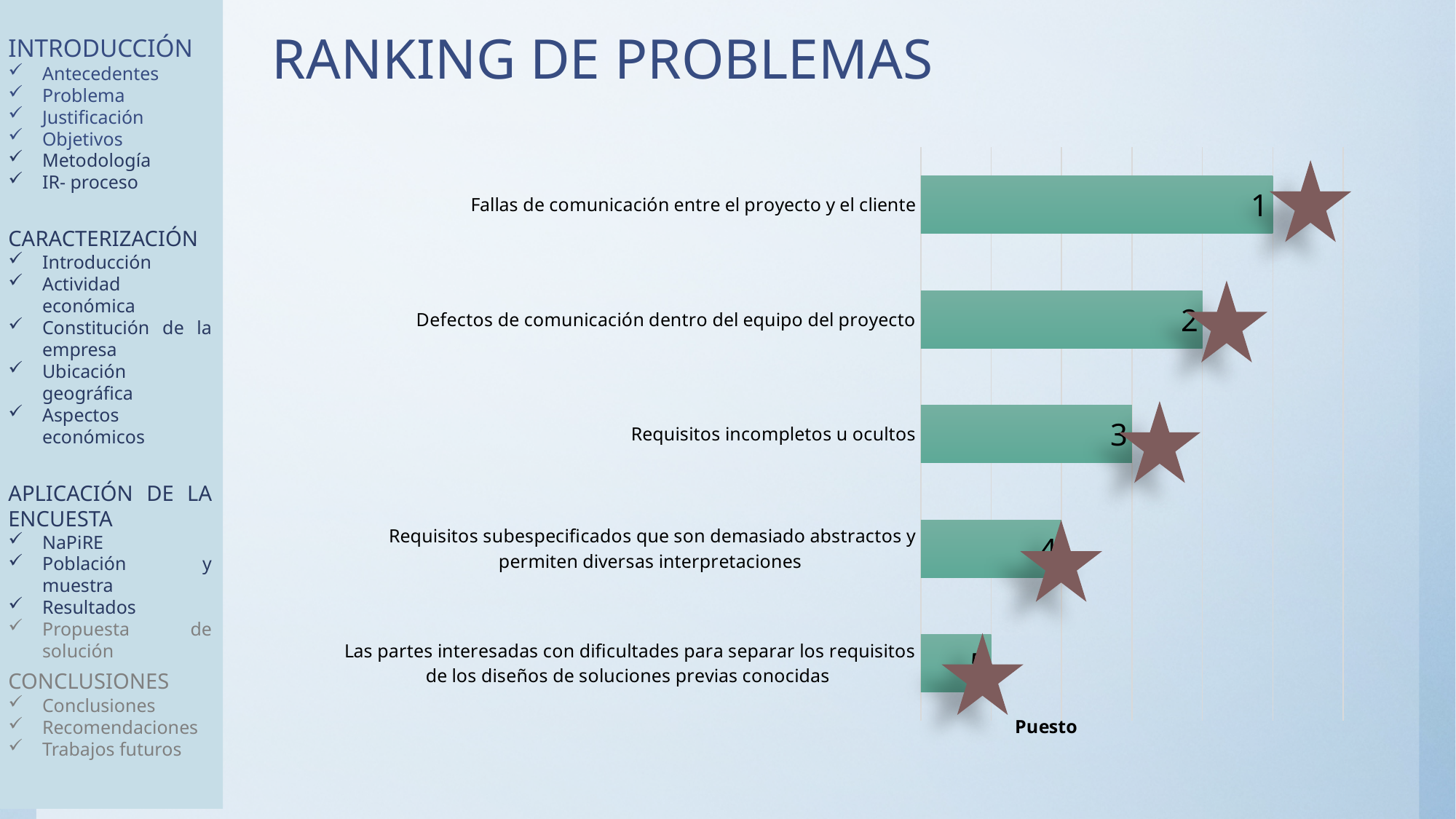
How many categories (problems) are plotted in the chart? 5 What is the axis title printed below the bars? Puesto Which bar is longer: 'Defectos de comunicación dentro del equipo del proyecto' or 'Requisitos incompletos u ocultos'? Defectos de comunicación dentro del equipo del proyecto Which category has the longest bar in the chart? Fallas de comunicación entre el proyecto y el cliente What label is printed on the bar for 'Requisitos incompletos u ocultos'? 3 Which category has the shortest bar in the chart? Las partes interesadas con dificultades para separar los requisitos de los diseños de soluciones previas conocidas Which bar is longer: 'Requisitos incompletos u ocultos' or 'Requisitos subespecificados que son demasiado abstractos y permiten diversas interpretaciones'? Requisitos incompletos u ocultos What is the title of the chart on the slide? RANKING DE PROBLEMAS What label is printed on the bar for 'Defectos de comunicación dentro del equipo del proyecto'? 2 What label is printed on the bar for 'Fallas de comunicación entre el proyecto y el cliente'? 1 What kind of chart is shown on the slide? bar chart Do the bar lengths increase or decrease going from the top category to the bottom category? decrease